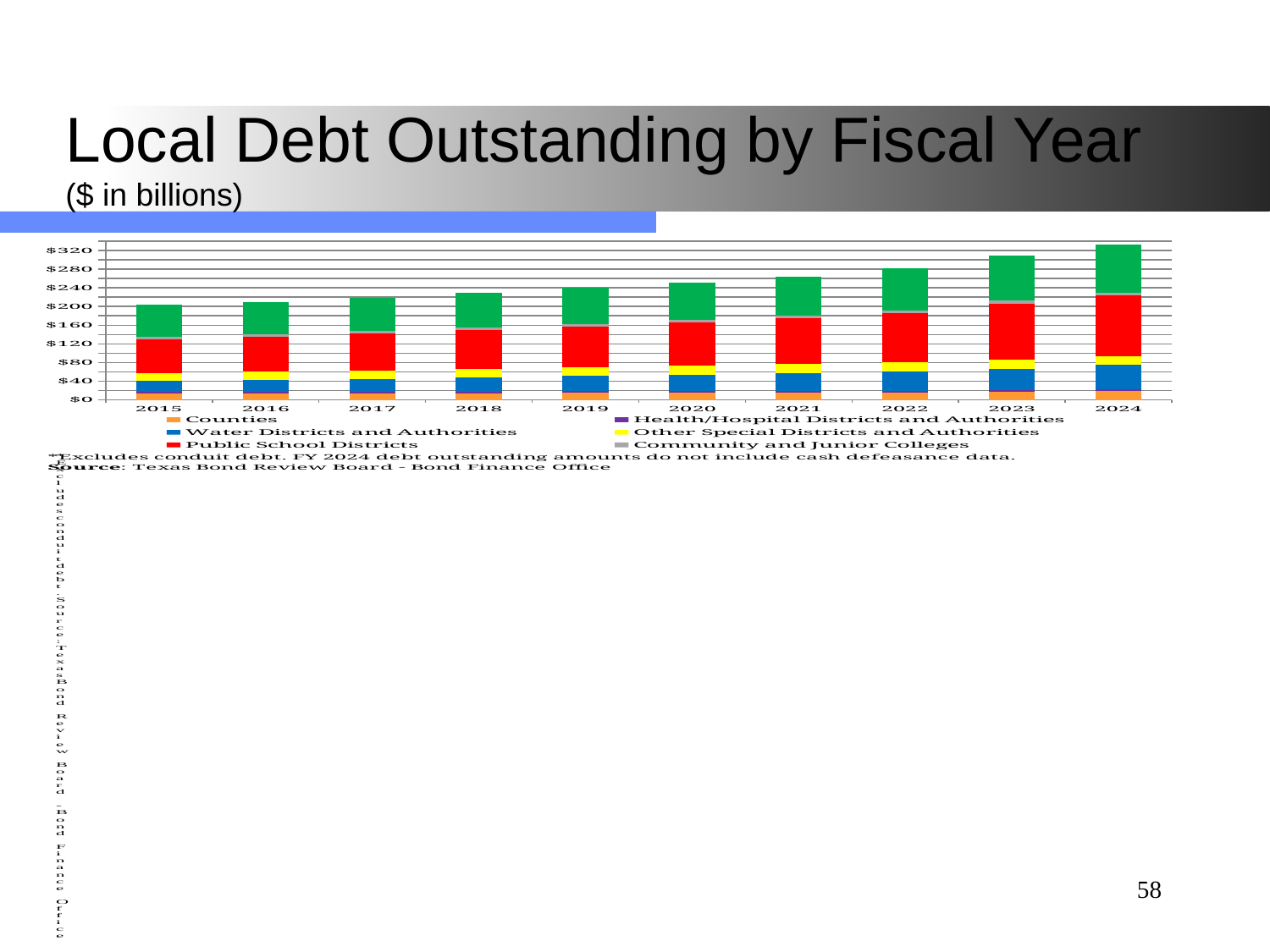
What kind of chart is shown on the slide? Stacked bar chart Which fiscal year has the tallest stacked bar (highest total local debt outstanding)? 2024 Is the total stacked bar for 2024 greater or less than $280? greater Which colour represents Public School Districts in the chart's legend? Red Which fiscal year has the shortest stacked bar (lowest total local debt outstanding)? 2015 Is the total stacked bar for 2021 greater or less than $240? greater Do the total stacked bar heights rise or fall from 2015 to 2024? Rise Is the total stacked bar for 2015 greater or less than $240? less How many fiscal years are shown on the x axis of the chart? 10 Which fiscal year has the larger total stacked bar, 2016 or 2022? 2022 How many series does the chart's legend list? 6